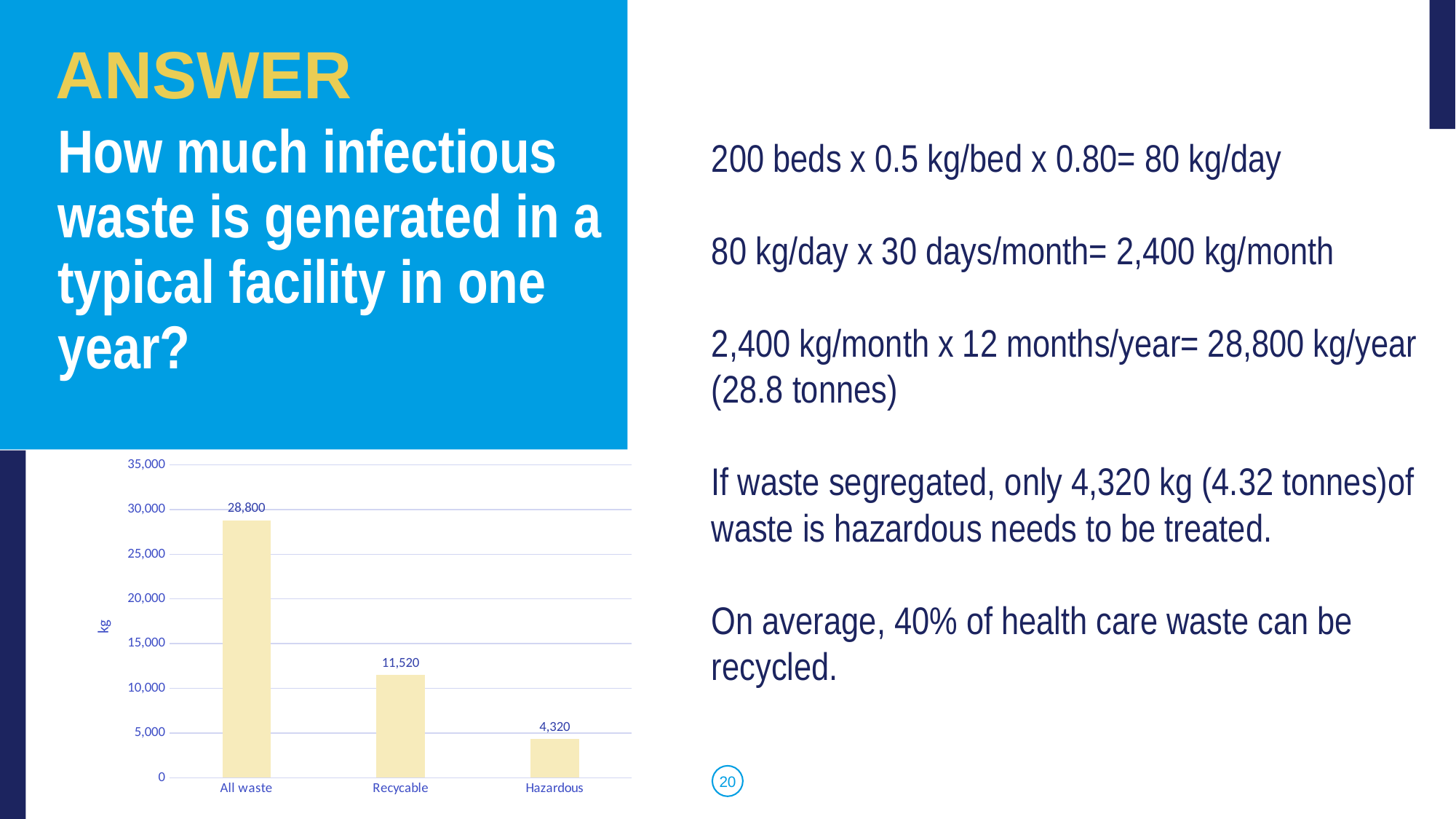
What is the label on the vertical axis of the chart? kg How many categories are shown in the chart? 3 What is the difference between the All waste and Recycable values? 17,280 What is the value for Recycable in the chart? 11,520 What is the difference between the Recycable and Hazardous values? 7,200 Which is larger, the value for Recycable or the value for Hazardous? Recycable What kind of chart is shown on the slide? bar chart Which category has the highest value in the chart? All waste Which category has the lowest value in the chart? Hazardous Is the value for Recycable greater or less than 10,000? greater What is the value for Hazardous in the chart? 4,320 What is the value for All waste in the chart? 28,800